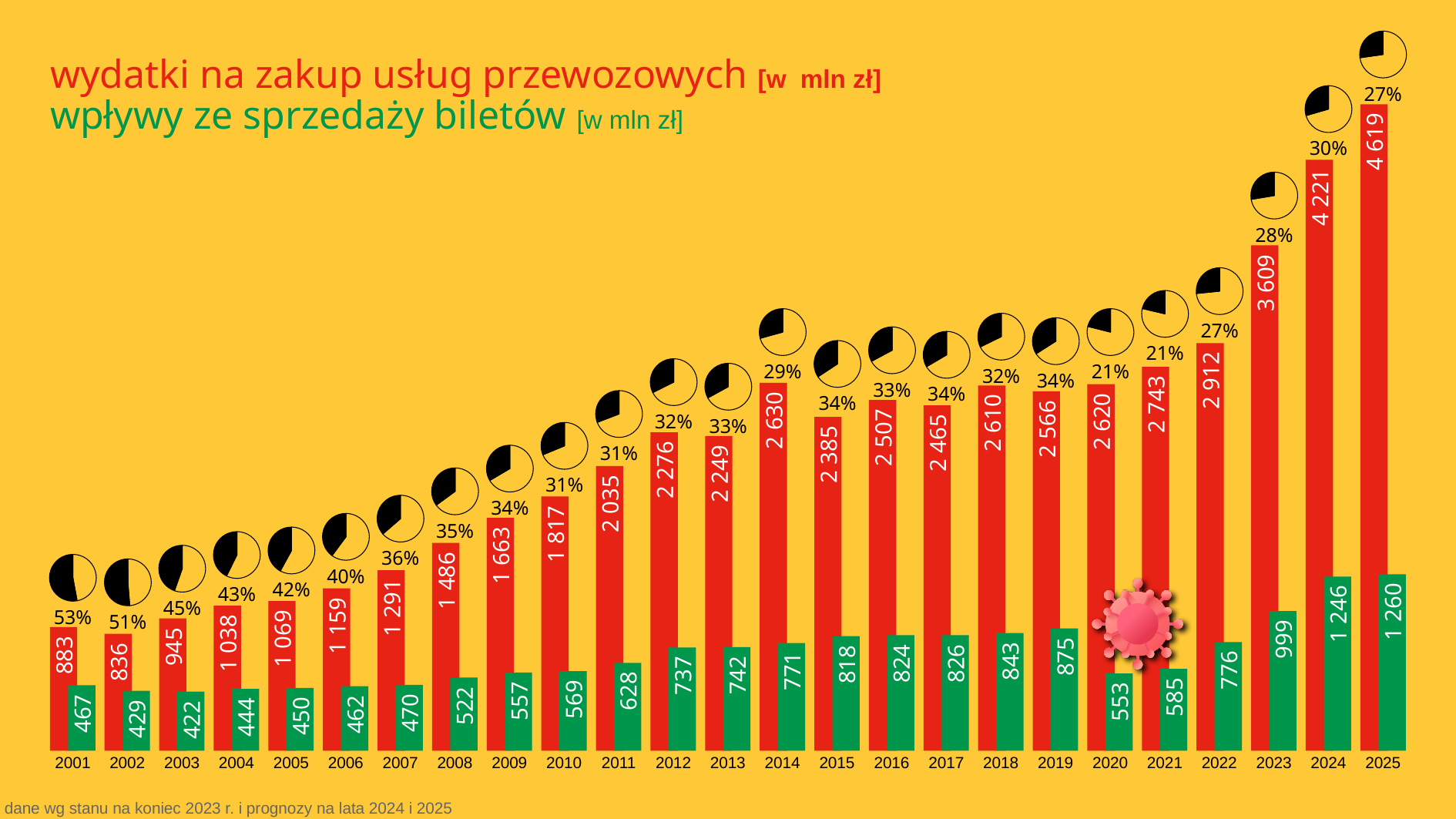
How many years are shown on the x axis? 25 Which year has higher wpływy ze sprzedaży biletów, 2014 or 2022? 2022 What kind of chart is this? bar chart In which year are wydatki na zakup usług przewozowych highest? 2025 What percentage is shown above the bars for 2020? 21% In which year are wpływy ze sprzedaży biletów lowest? 2003 What is the value of wydatki na zakup usług przewozowych for 2010? 1 817 Which colour represents wpływy ze sprzedaży biletów? green What is the difference between wydatki na zakup usług przewozowych and wpływy ze sprzedaży biletów in 2025? 3 359 How many data series does the chart show? 2 By how much did wpływy ze sprzedaży biletów fall from 2019 to 2020? 322 What is the value of wpływy ze sprzedaży biletów for 2019? 875